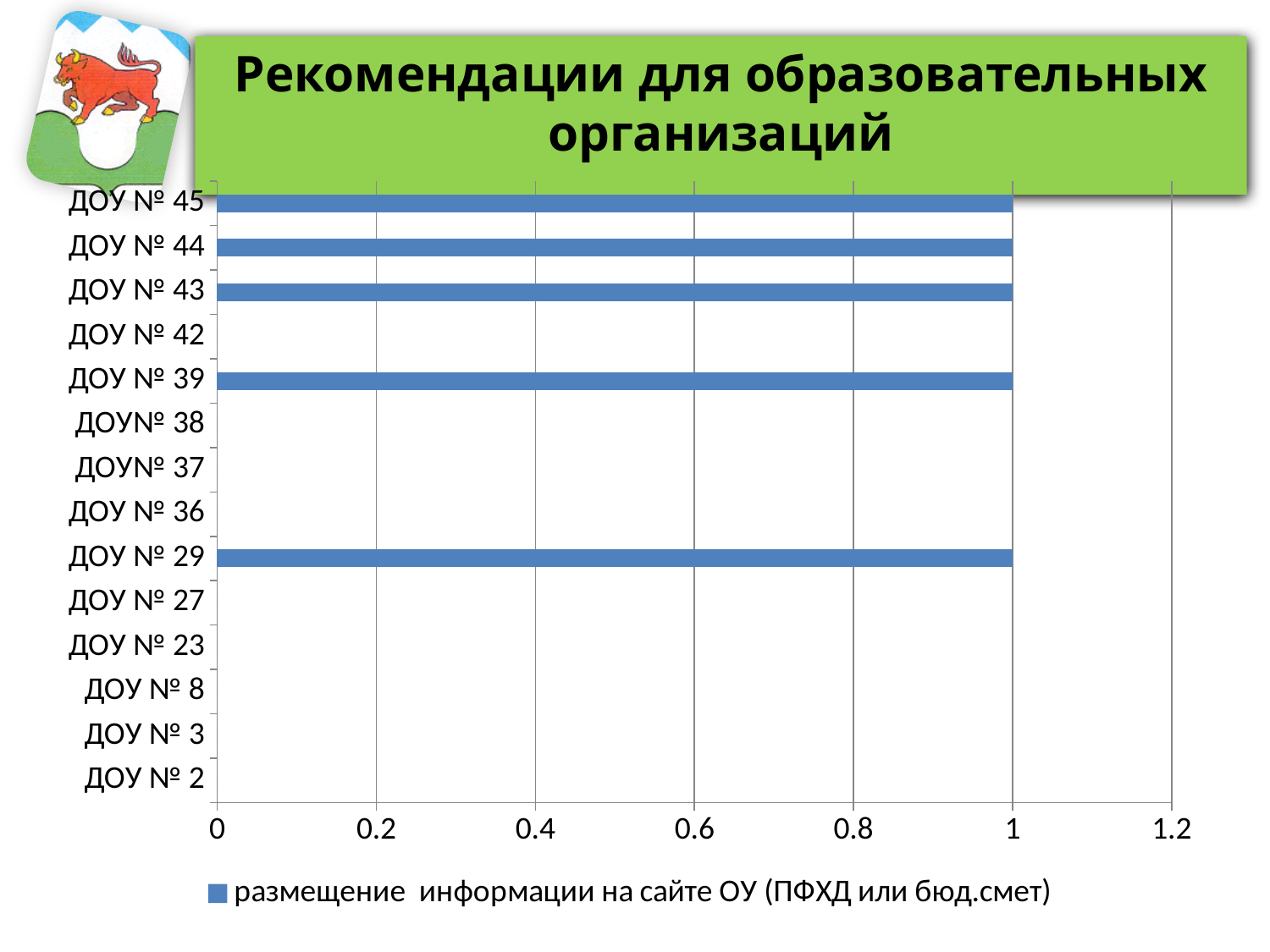
What is the legend entry of the series shown in the chart? размещение информации на сайте ОУ (ПФХД или бюд.смет) What is the value for ДОУ № 29 in the chart? 1 What is the value for ДОУ № 39 in the chart? 1 How many categories (ДОУ) are listed on the vertical axis of the chart? 14 How many series does the chart legend list? 1 How many categories in the chart have a visible bar? 5 What is the value for ДОУ № 45 in the chart? 1 Is the value for ДОУ № 43 greater or less than 0.8? greater What is the highest value shown on the horizontal axis of the chart? 1.2 Which is larger, the value for ДОУ № 44 or the value for ДОУ № 36? ДОУ № 44 Is the value for ДОУ № 42 greater or less than 0.2? less What kind of chart is shown on the slide? bar chart